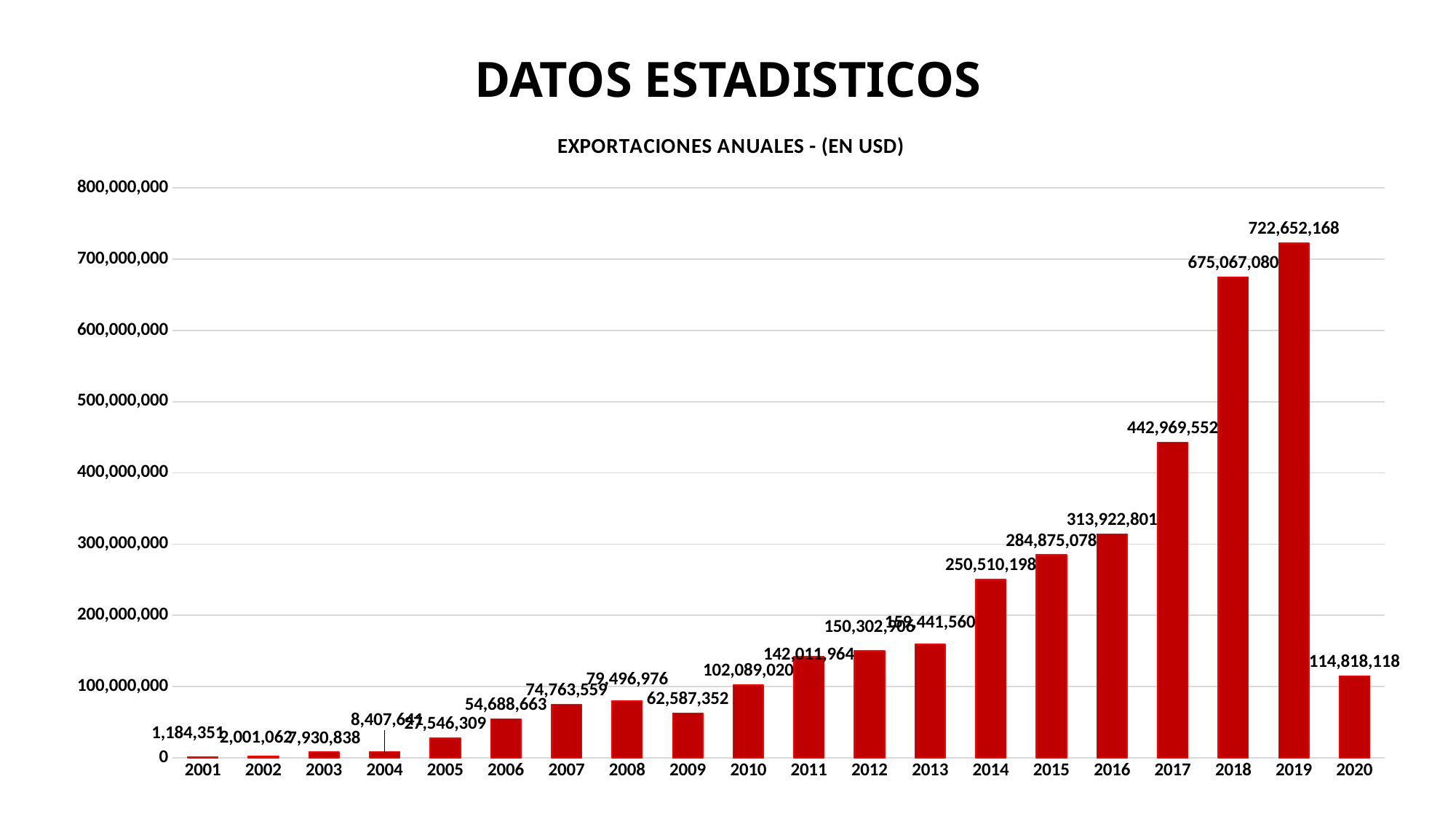
Which year has the lowest value? 2001 Is the value for 2017 greater or less than 400,000,000? greater How many years are shown on the x axis? 20 What is the value for 2010? 102,089,020 Which year has the larger value, 2008 or 2009? 2008 Which year has the highest value? 2019 Do the values rise or fall from 2014 to 2019? rise What kind of chart is this? bar chart What is the value for 2019? 722,652,168 What is the difference between the values for 2019 and 2018? 47,585,088 What is the title of the chart? EXPORTACIONES ANUALES - (EN USD) What is the value for 2020? 114,818,118